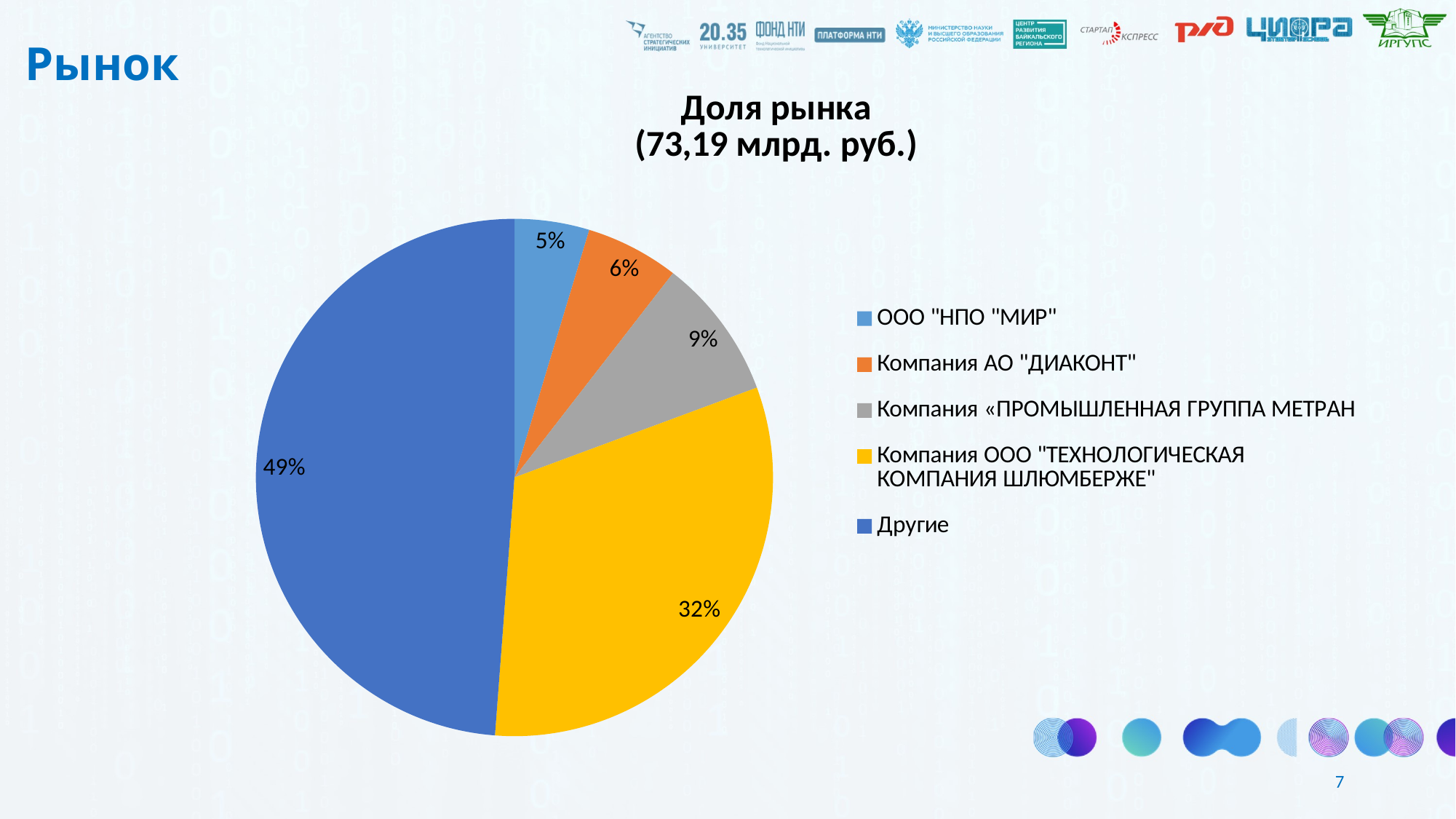
Which category has the smallest slice of the pie? ООО "НПО "МИР" What share of the pie does Компания АО "ДИАКОНТ" hold? 6% What share of the pie does Другие hold? 49% What type of chart is shown on the slide? pie chart Which category has the largest slice of the pie? Другие What is the title of the chart? Доля рынка (73,19 млрд. руб.) What is the difference between the share of Другие and the share of Компания ООО "ТЕХНОЛОГИЧЕСКАЯ КОМПАНИЯ ШЛЮМБЕРЖЕ"? 17% What share of the pie does Компания «ПРОМЫШЛЕННАЯ ГРУППА МЕТРАН hold? 9% Which has a larger share: Компания АО "ДИАКОНТ" or Компания «ПРОМЫШЛЕННАЯ ГРУППА МЕТРАН? Компания «ПРОМЫШЛЕННАЯ ГРУППА МЕТРАН How many categories does the pie chart show? 5